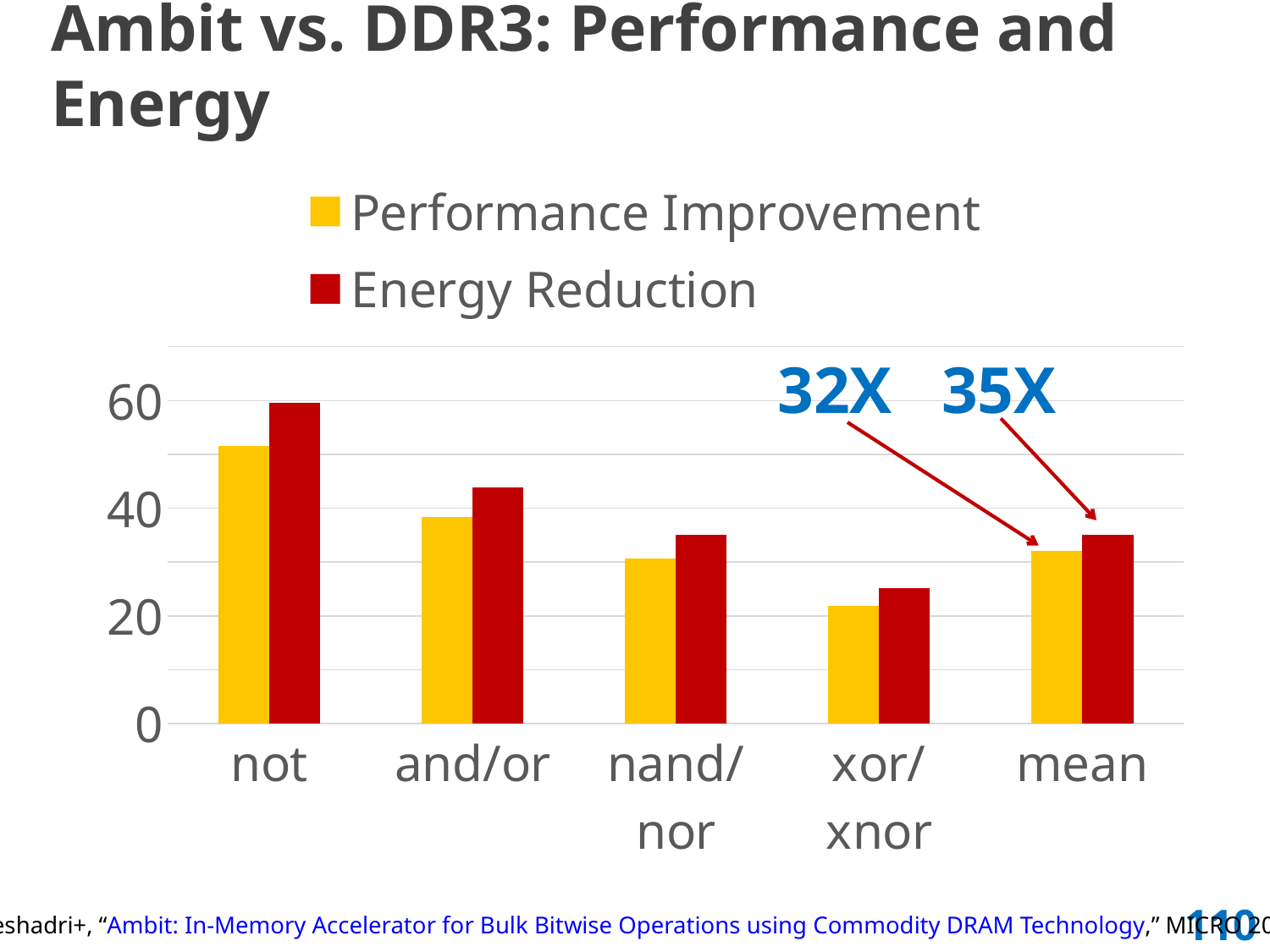
What is the difference between the Energy Reduction and Performance Improvement values for mean? 3X What is the Energy Reduction value for mean? 35X What kind of chart is shown on the slide? bar chart What is the Performance Improvement value for mean? 32X Is the Energy Reduction value for not greater or less than 40? greater How many categories are shown on the x axis? 5 What colour represents Energy Reduction in the chart? red Which has a larger Performance Improvement, not or and/or? not Is the Performance Improvement value for nand/nor greater or less than 40? less Which category has the lowest Performance Improvement? xor/xnor Which category has the highest Energy Reduction? not How many series does the legend list? 2